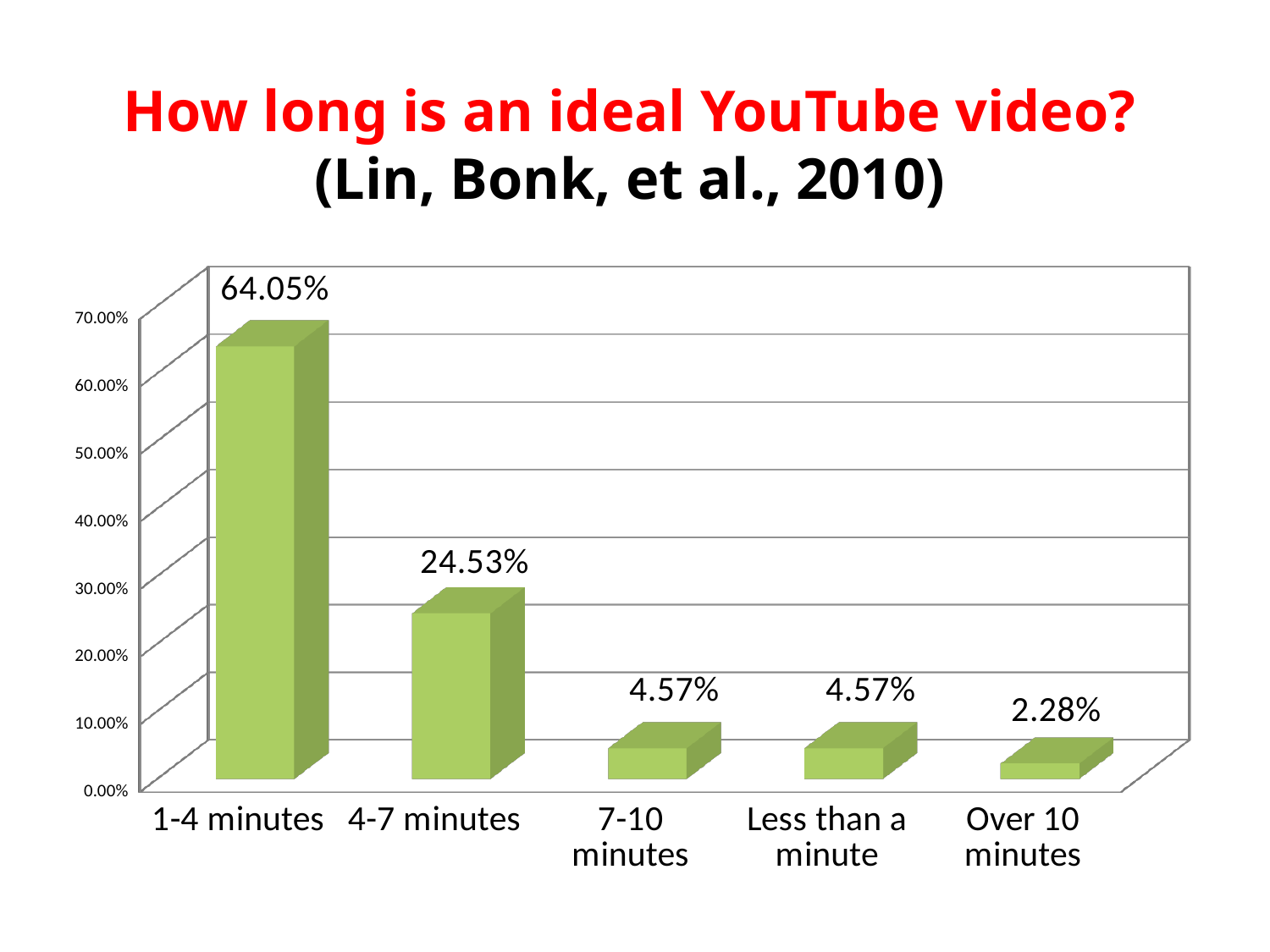
What is the title of the slide containing the chart? How long is an ideal YouTube video? (Lin, Bonk, et al., 2010) Which category has the lowest value? Over 10 minutes Is the value for 1-4 minutes greater or less than 60.00%? greater What is the difference between the values for 1-4 minutes and 4-7 minutes? 39.52% What kind of chart is shown on the slide? bar chart What is the value shown for 4-7 minutes? 24.53% Which category has the highest value? 1-4 minutes What is the value shown for Over 10 minutes? 2.28% How many categories are shown on the x axis? 5 What is the value shown for Less than a minute? 4.57% Which is larger, the value for 4-7 minutes or the value for 7-10 minutes? 4-7 minutes What percentage of respondents chose 1-4 minutes as the ideal YouTube video length? 64.05%